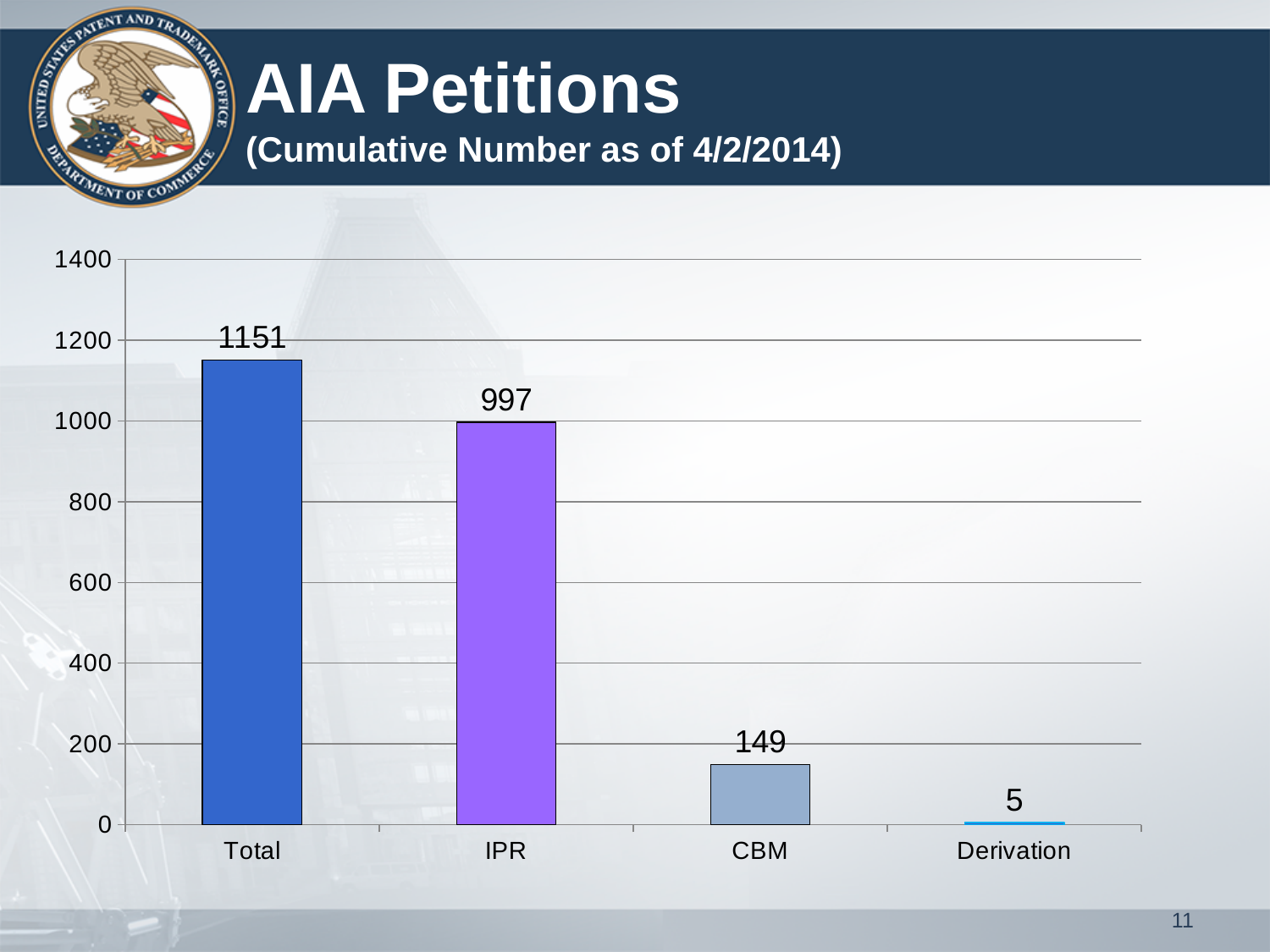
What is the value for Total? 1151 What kind of chart is shown on the slide? bar chart What is the value for Derivation? 5 What is the difference between the values for Total and IPR? 154 Which is larger, the value for CBM or the value for Derivation? CBM What is the value for CBM? 149 What is the value for IPR? 997 Which category has the highest value? Total Which category has the lowest value? Derivation How many categories are shown on the x axis? 4 Is the value for IPR greater or less than 800? greater What is the difference between the values for IPR and CBM? 848